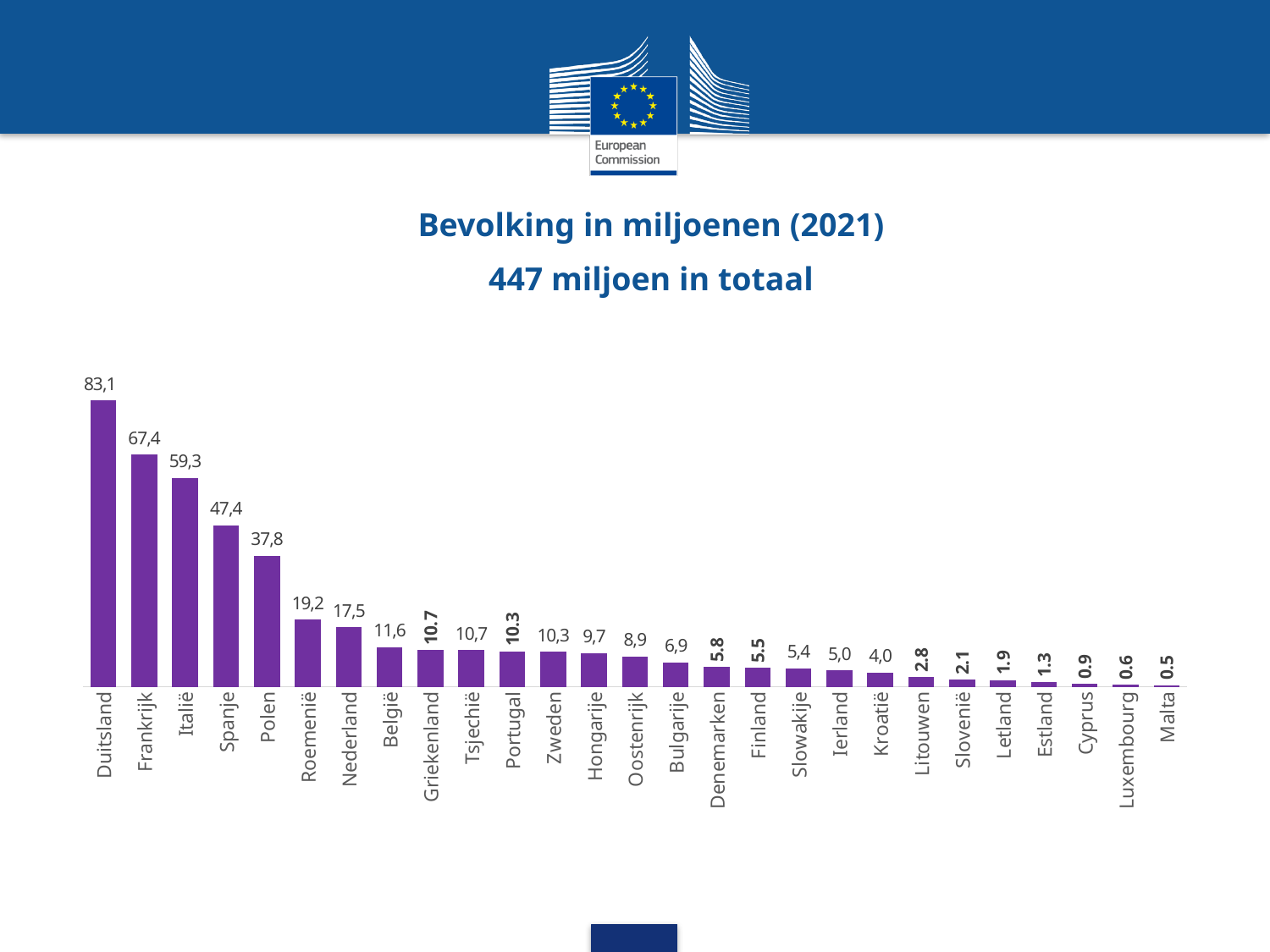
What is the value for Nederland? 17,5 What is the difference between the values for Duitsland and Frankrijk? 15,7 What is the value for Duitsland? 83,1 Which country has the lowest value? Malta Which is larger, the value for Zweden or the value for Hongarije? Zweden What is the value for Malta? 0.5 What kind of chart is shown on the slide? bar chart What is the value for Denemarken? 5.8 What is the difference between the values for Polen and Roemenië? 18,6 How many countries are shown in the chart? 27 Which country has the highest value? Duitsland Do the values rise or fall from left to right along the x axis? fall